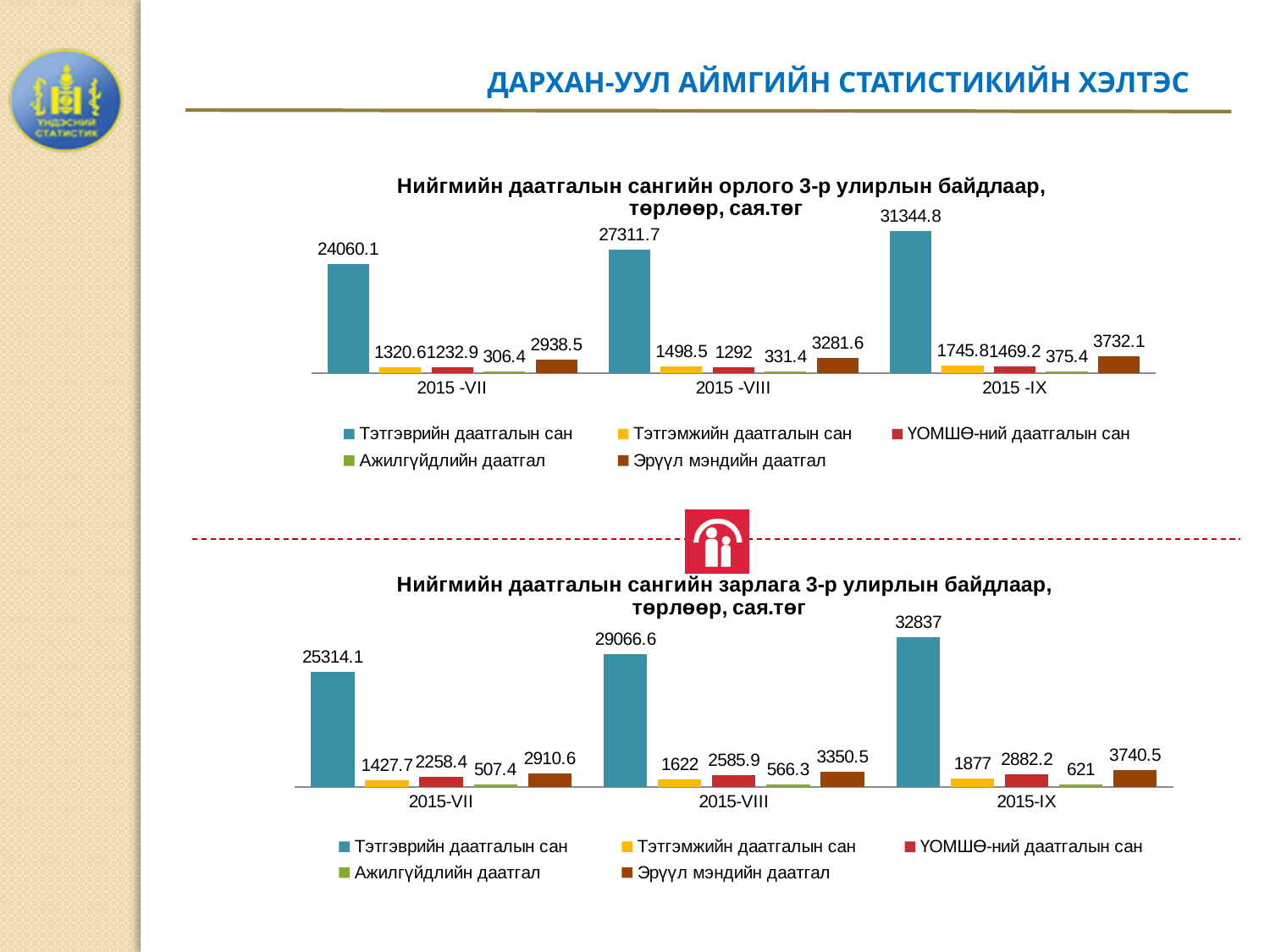
How many categories are shown on the x axis of the bottom chart (Нийгмийн даатгалын сангийн зарлага)? 3 What kind of chart is the bottom chart (Нийгмийн даатгалын сангийн зарлага)? Bar chart In the top chart (Нийгмийн даатгалын сангийн орлого), what is the difference between the Тэтгэврийн даатгалын сан values for 2015 -IX and 2015 -VIII? 4033.1 In the top chart (Нийгмийн даатгалын сангийн орлого), does the value of Эрүүл мэндийн даатгал rise or fall from 2015 -VII to 2015 -IX? Rise In the top chart (Нийгмийн даатгалын сангийн орлого), what is the value of Эрүүл мэндийн даатгал for 2015 -VII? 2938.5 In the bottom chart (Нийгмийн даатгалын сангийн зарлага), what is the value of ҮОМШӨ-ний даатгалын сан for 2015-VIII? 2585.9 In the bottom chart (Нийгмийн даатгалын сангийн зарлага), which is larger in 2015-IX: Тэтгэмжийн даатгалын сан or ҮОМШӨ-ний даатгалын сан? ҮОМШӨ-ний даатгалын сан In the bottom chart (Нийгмийн даатгалын сангийн зарлага), which series has the lowest value in 2015-VII? Ажилгүйдлийн даатгал In the top chart (Нийгмийн даатгалын сангийн орлого), which month has the highest value for Тэтгэврийн даатгалын сан? 2015 -IX In the top chart (Нийгмийн даатгалын сангийн орлого), what is the value of Тэтгэврийн даатгалын сан for 2015 -IX? 31344.8 How many series does the legend of the top chart (Нийгмийн даатгалын сангийн орлого) list? 5 In the bottom chart (Нийгмийн даатгалын сангийн зарлага), what is the value of Ажилгүйдлийн даатгал for 2015-IX? 621